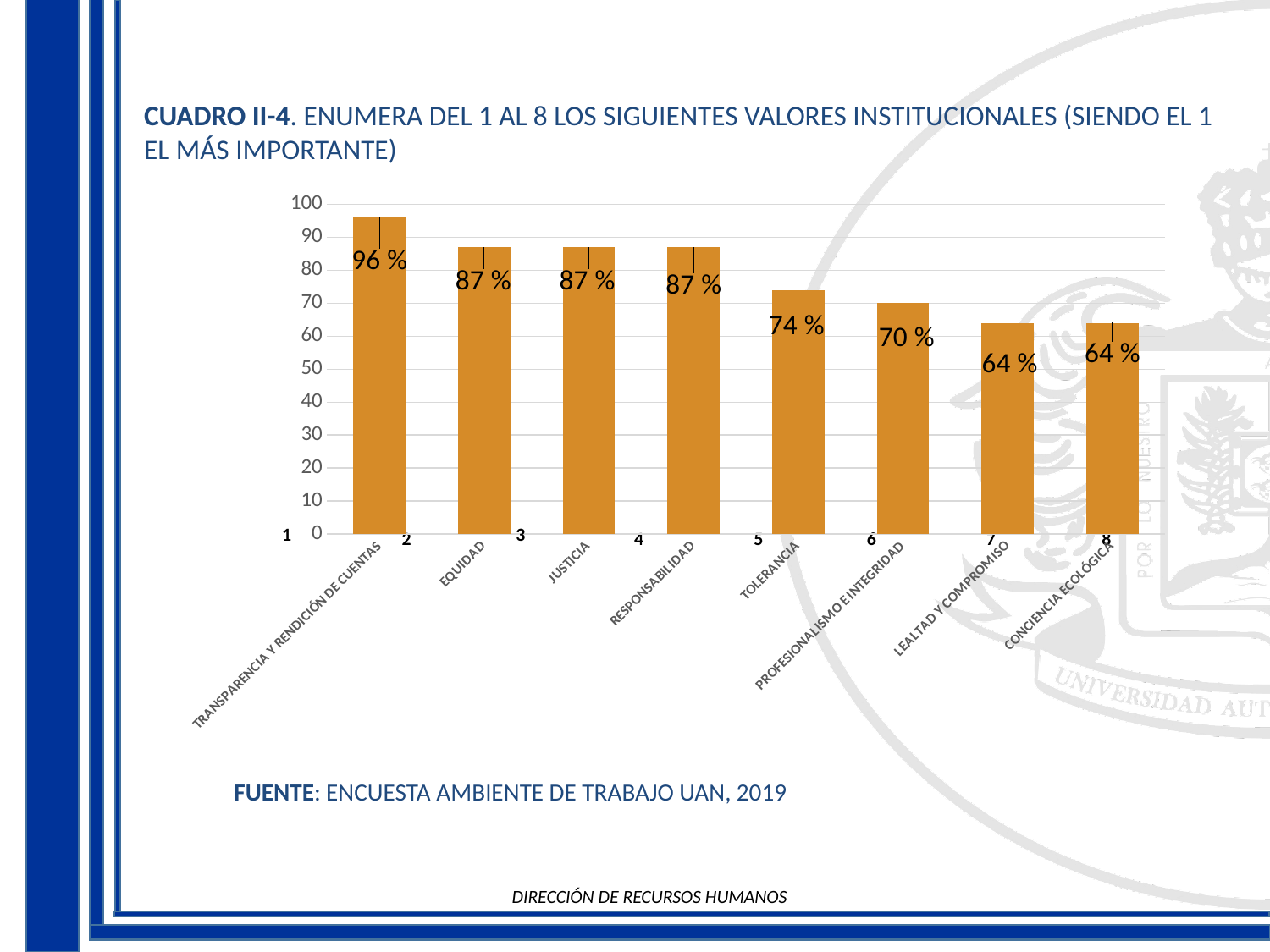
What is the value for TRANSPARENCIA Y RENDICIÓN DE CUENTAS? 96 % Which is larger, the value for TOLERANCIA or the value for LEALTAD Y COMPROMISO? TOLERANCIA What is the value for EQUIDAD? 87 % Do the values rise or fall from left to right along the x axis? fall What is the value for PROFESIONALISMO E INTEGRIDAD? 70 % How many categories are shown in the chart? 8 What is the value for TOLERANCIA? 74 % What is the difference between the values for JUSTICIA and TOLERANCIA? 13 % Which category has the highest value? TRANSPARENCIA Y RENDICIÓN DE CUENTAS What kind of chart is shown on the slide? bar chart What is the difference between the values for TRANSPARENCIA Y RENDICIÓN DE CUENTAS and CONCIENCIA ECOLÓGICA? 32 % Is the value for PROFESIONALISMO E INTEGRIDAD greater or less than 80? less